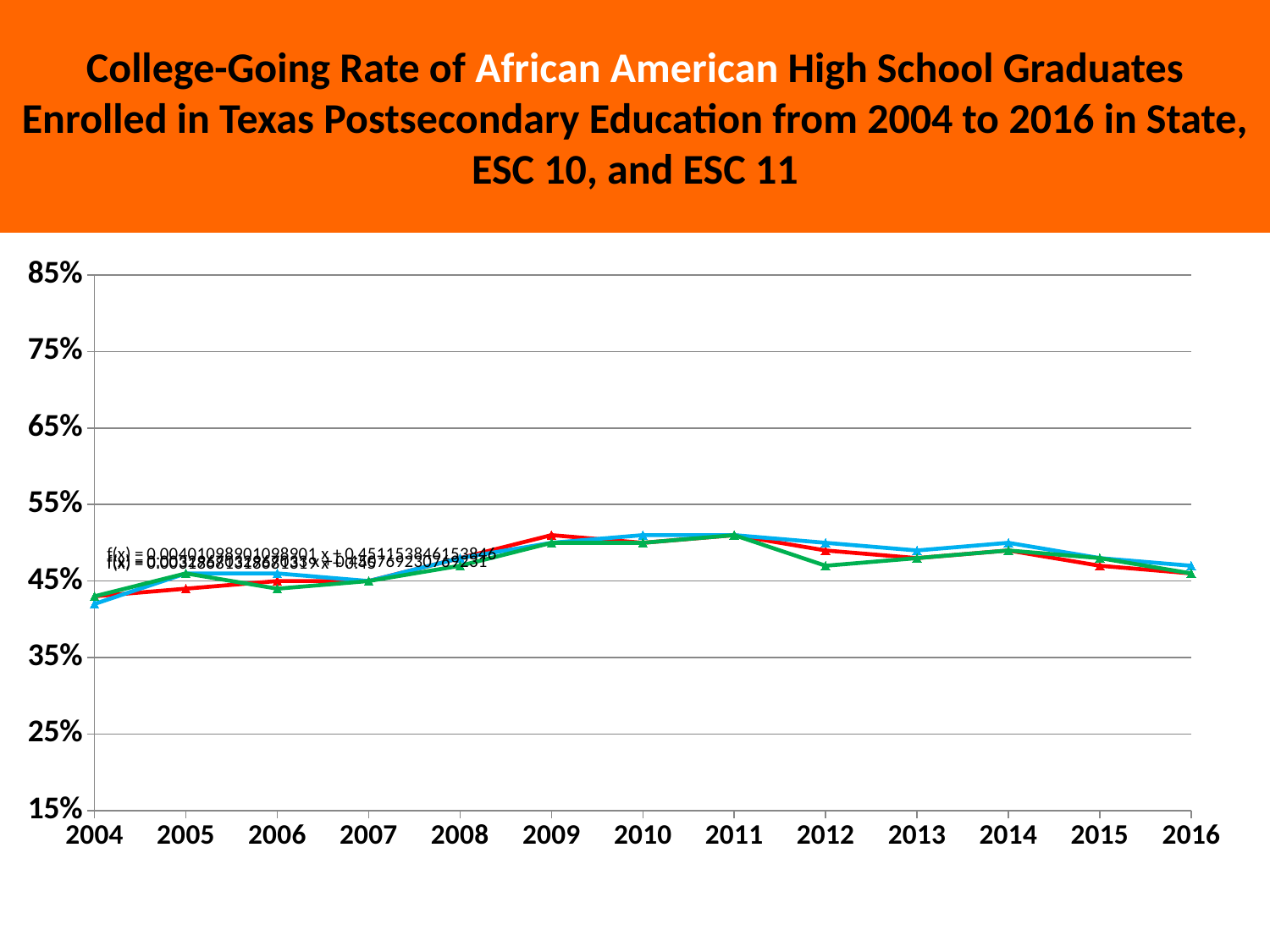
Is the value of the red line in 2009 greater or less than 45%? greater Do the plotted values generally rise or fall from 2014 to 2016? fall Is the value of the blue line in 2011 greater or less than 55%? less In 2012, is the blue line higher or lower than the green line? higher Is the value of the green line in 2004 greater or less than 45%? less Which three regions does the chart title say are compared? State, ESC 10, and ESC 11 Do the plotted values generally rise or fall from 2004 to 2009? rise For the green line, is the value in 2011 higher or lower than in 2004? higher What kind of chart is shown on the slide? line chart What is the highest value shown on the y axis? 85% How many years are plotted along the x axis? 13